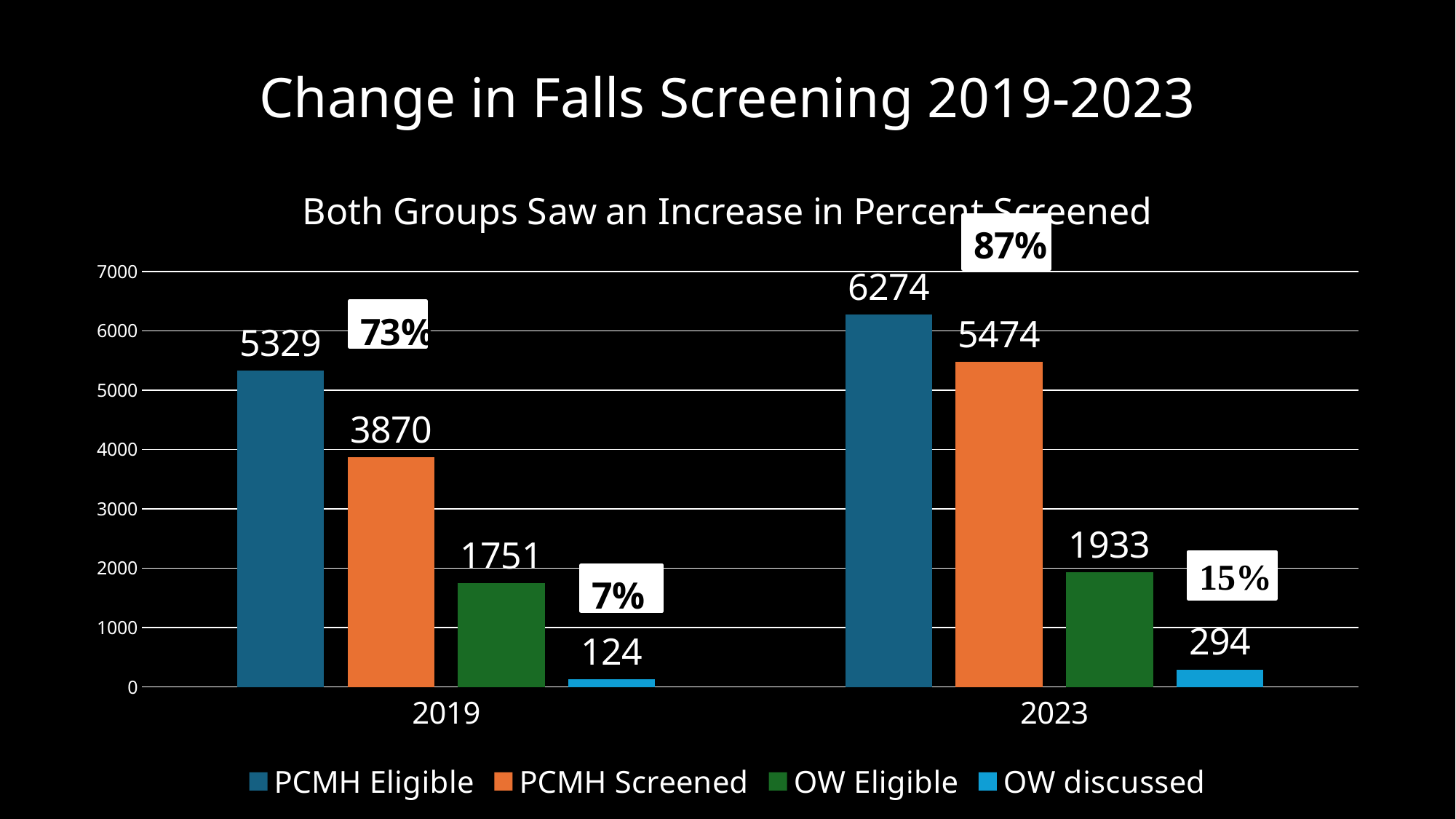
Which series has the highest value in 2023? PCMH Eligible How many series does the legend list? 4 Does the value for PCMH Screened rise or fall from 2019 to 2023? Rise What is the value for OW discussed in 2019? 124 Which is larger: OW Eligible in 2019 or OW Eligible in 2023? OW Eligible in 2023 What kind of chart is shown on the slide? Bar chart What is the value for PCMH Screened in 2023? 5474 What is the value for PCMH Eligible in 2019? 5329 What is the difference between PCMH Eligible in 2023 and PCMH Eligible in 2019? 945 What is the chart's title? Both Groups Saw an Increase in Percent Screened Which series has the lowest value in 2019? OW discussed What is the value for OW Eligible in 2023? 1933